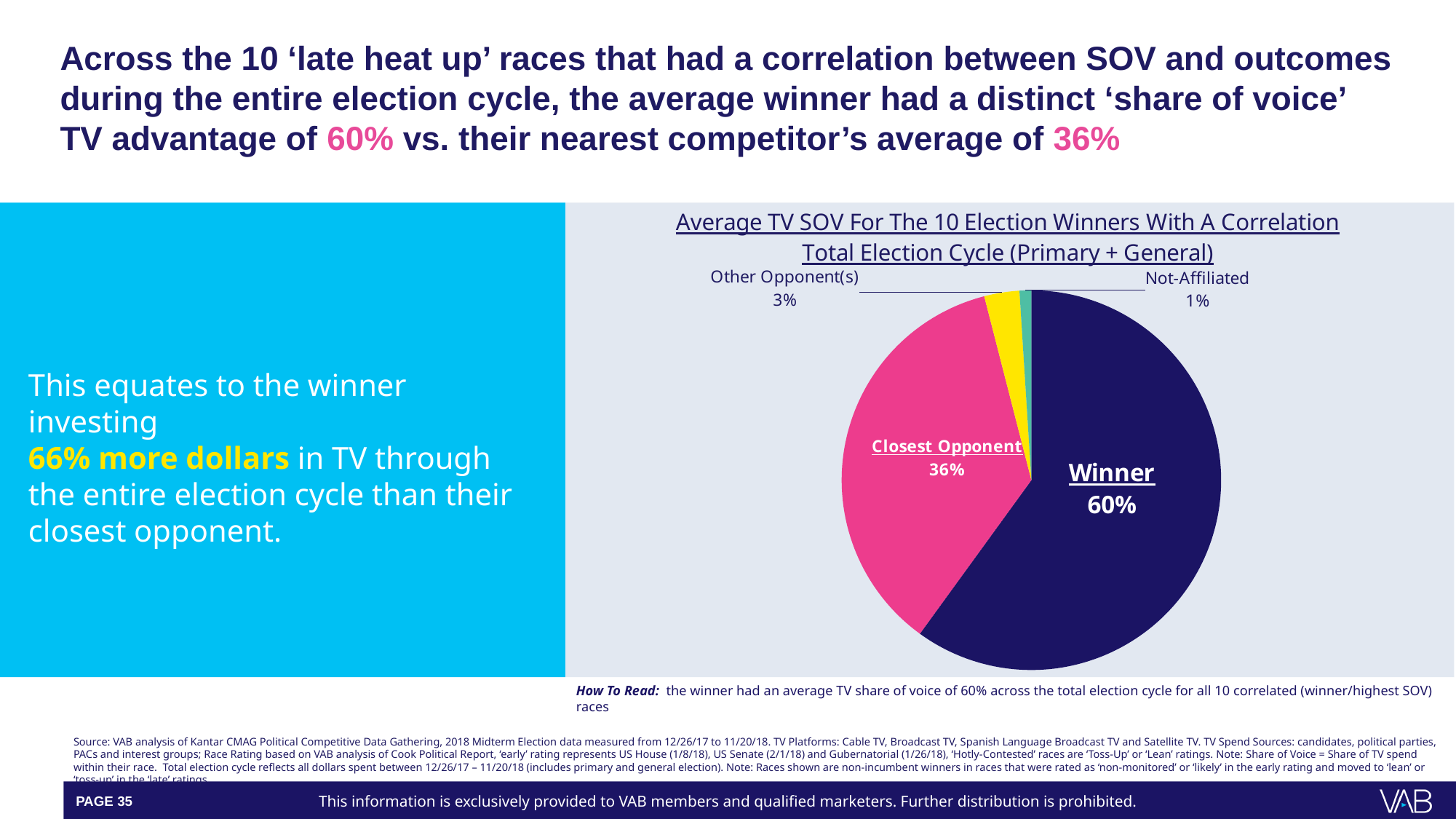
What colour is the Closest Opponent slice? Pink How many slices does the pie chart have? 4 Which is larger, the Other Opponent(s) slice or the Not-Affiliated slice? Other Opponent(s) Which slice of the pie is the smallest? Not-Affiliated What type of chart is shown on the slide? Pie chart Which slice of the pie is the largest? Winner What is the difference in percentage points between the Winner and Closest Opponent slices? 24 What percentage is shown for Not-Affiliated? 1% What percentage is shown for Other Opponent(s)? 3% What is the title of the chart? Average TV SOV For The 10 Election Winners With A Correlation Total Election Cycle (Primary + General) What share of the pie does the Winner slice represent? 60% What is the value shown for Closest Opponent? 36%